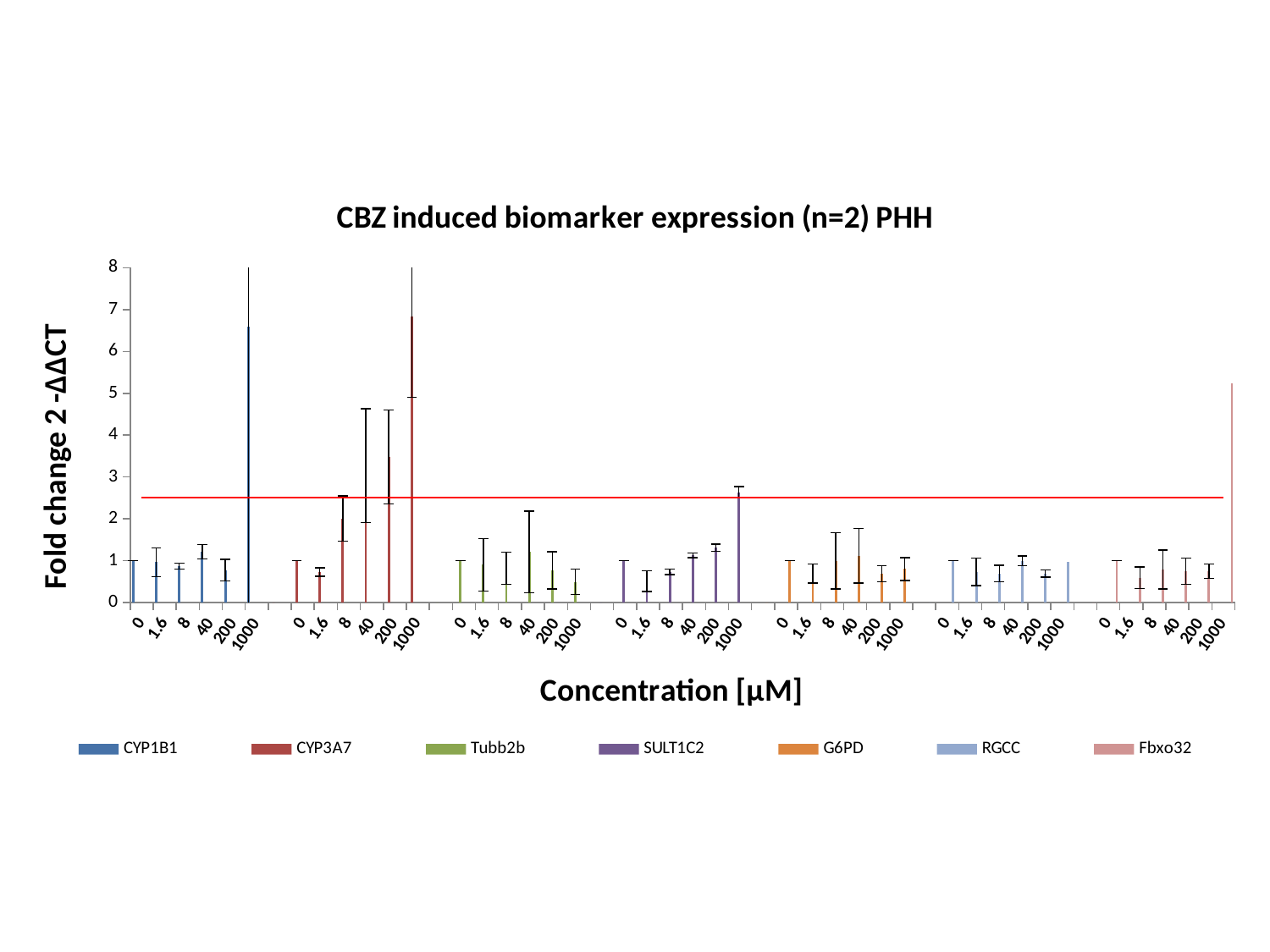
Which series has the highest bar at 1000 µM? CYP3A7 Is the value for CYP1B1 at 1000 µM greater or less than 5? greater What is the label of the x axis? Concentration [µM] What kind of chart is shown on the slide? bar chart At 1000 µM, which is larger: the value for CYP1B1 or the value for CYP3A7? CYP3A7 How many concentration levels are plotted for each series? 6 How many series does the legend list? 7 Is the value for SULT1C2 at 1000 µM greater or less than 2? greater Is the value for CYP3A7 at 1000 µM greater or less than 4? greater What is the title of the chart? CBZ induced biomarker expression (n=2) PHH